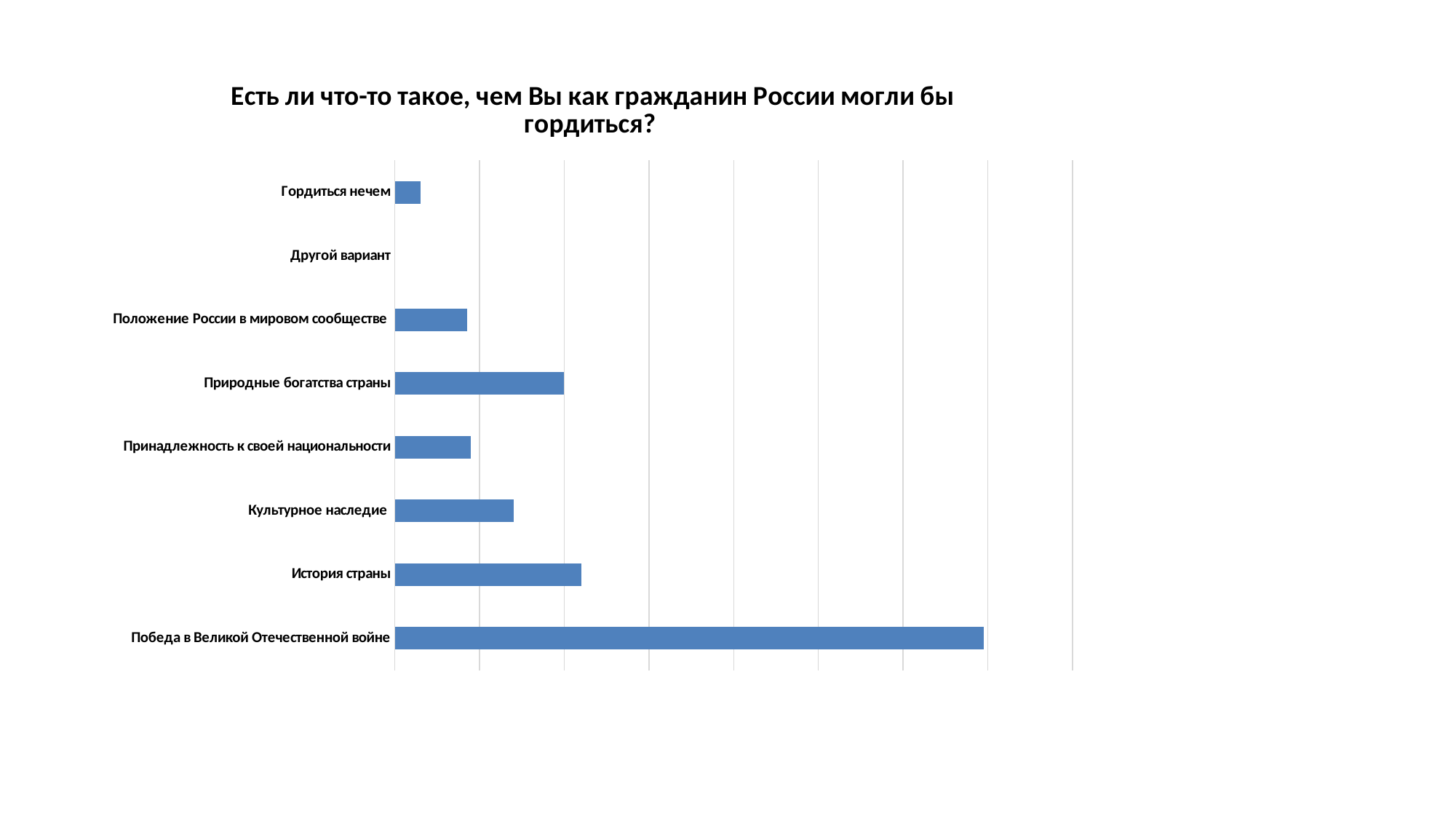
Which category has the highest value? Победа в Великой Отечественной войне What colour are the bars in the chart? blue Which is larger: the value for Победа в Великой Отечественной войне or the value for История страны? Победа в Великой Отечественной войне Among the categories with a visible bar, which one has the shortest bar? Гордиться нечем How many categories are listed on the chart? 8 Which is larger: the value for Гордиться нечем or the value for Положение России в мировом сообществе? Положение России в мировом сообществе Which is larger: the value for История страны or the value for Культурное наследие? История страны Which category has no visible bar at all (the lowest value)? Другой вариант What is the title of the chart? Есть ли что-то такое, чем Вы как гражданин России могли бы гордиться? What kind of chart is shown on the slide? bar chart